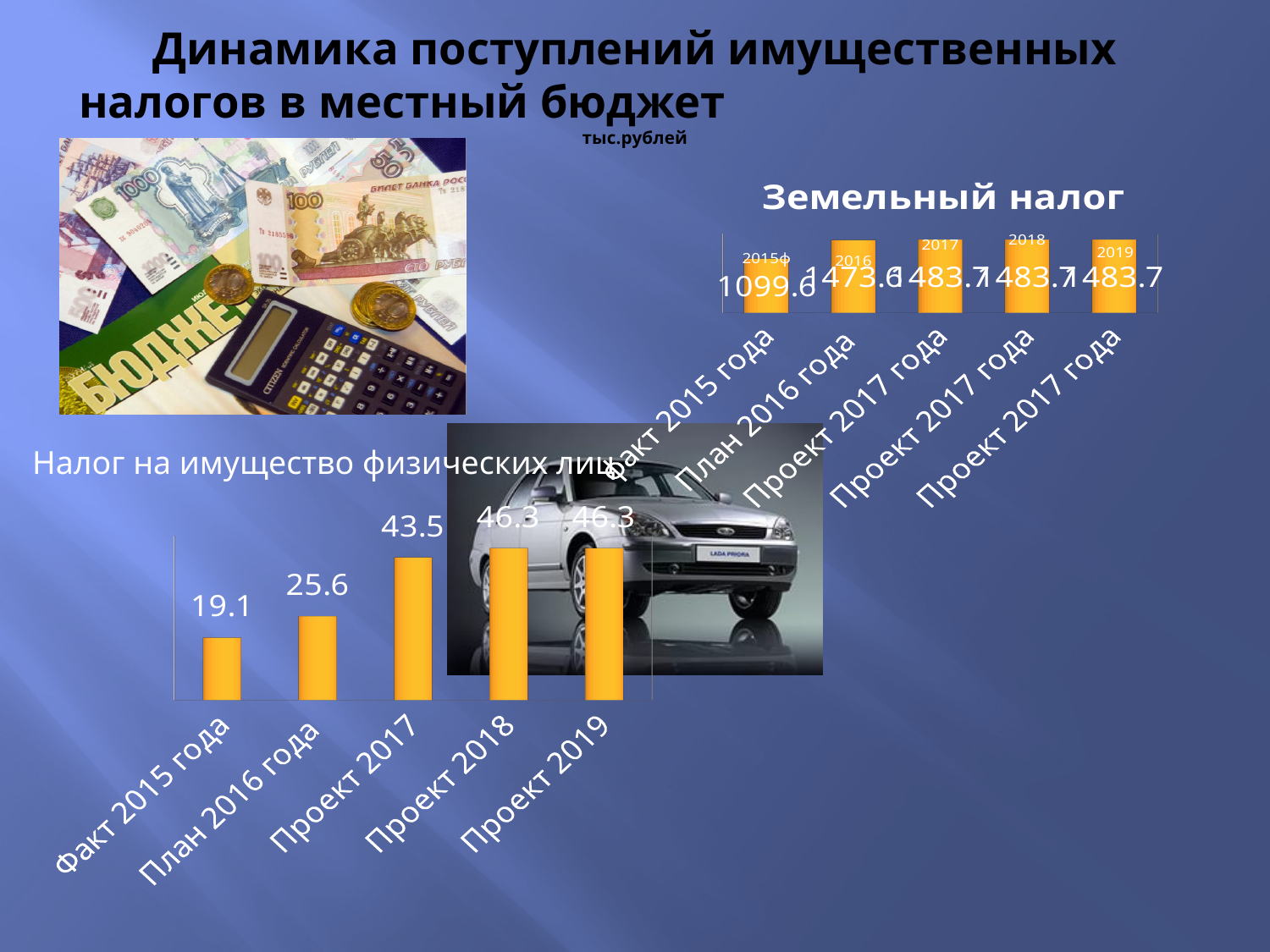
On the chart 'Налог на имущество физических лиц', what is the value for 'Проект 2017'? 43.5 On the chart 'Земельный налог', which category has the lowest value? Факт 2015 года On the chart 'Налог на имущество физических лиц', what is the value for 'Проект 2019'? 46.3 On the chart 'Налог на имущество физических лиц', how many bars are plotted? 5 What type of chart is 'Земельный налог'? bar chart On the chart 'Налог на имущество физических лиц', what is the difference between 'Проект 2017' and 'План 2016 года'? 17.9 On the chart 'Налог на имущество физических лиц', which category has the lowest value? Факт 2015 года On the chart 'Земельный налог', what is the value for 'План 2016 года'? 1473.6 On the chart 'Налог на имущество физических лиц', what is the value for 'Факт 2015 года'? 19.1 On the chart 'Налог на имущество физических лиц', what is the value for 'План 2016 года'? 25.6 On the chart 'Налог на имущество физических лиц', do the values generally rise or fall from left to right? rise On the chart 'Земельный налог', what is the value for 'Факт 2015 года'? 1099.6